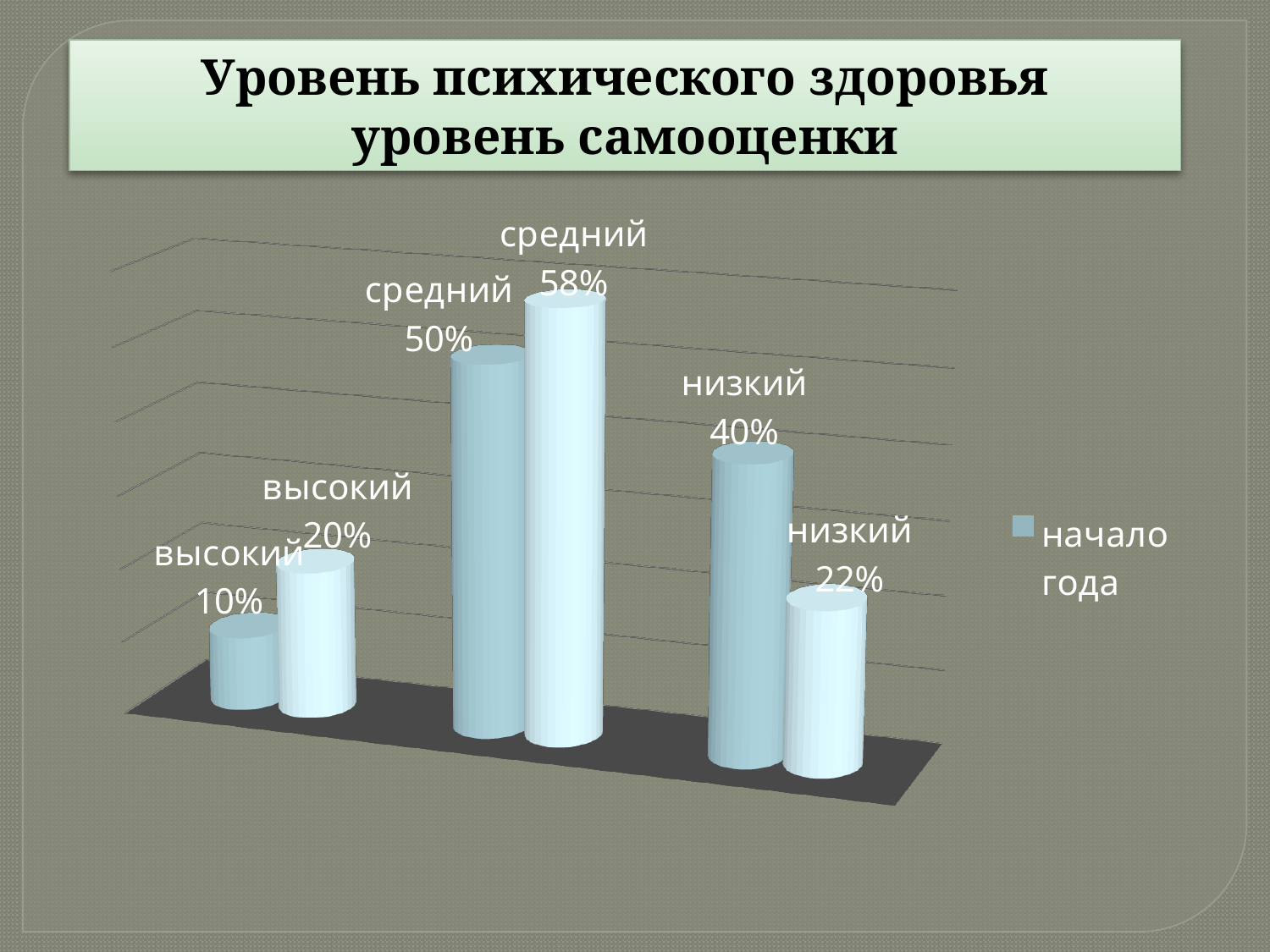
Which category has the highest value in the начало года series? средний What is the value for средний in the начало года series? 50% What is the value for высокий in the начало года series? 10% What is the value shown on the second (lighter) bar for низкий? 22% What is the difference between the two bars for низкий (40% and 22%)? 18% Which category has the lowest value in the начало года series? высокий Which is larger for высокий: the начало года bar or the second (lighter) bar? the second (lighter) bar What type of chart is shown on the slide? bar chart What is the difference between the two bars for средний (58% and 50%)? 8% How many categories are shown on the chart? 3 What is the value shown on the second (lighter) bar for средний? 58% What is the value for низкий in the начало года series? 40%